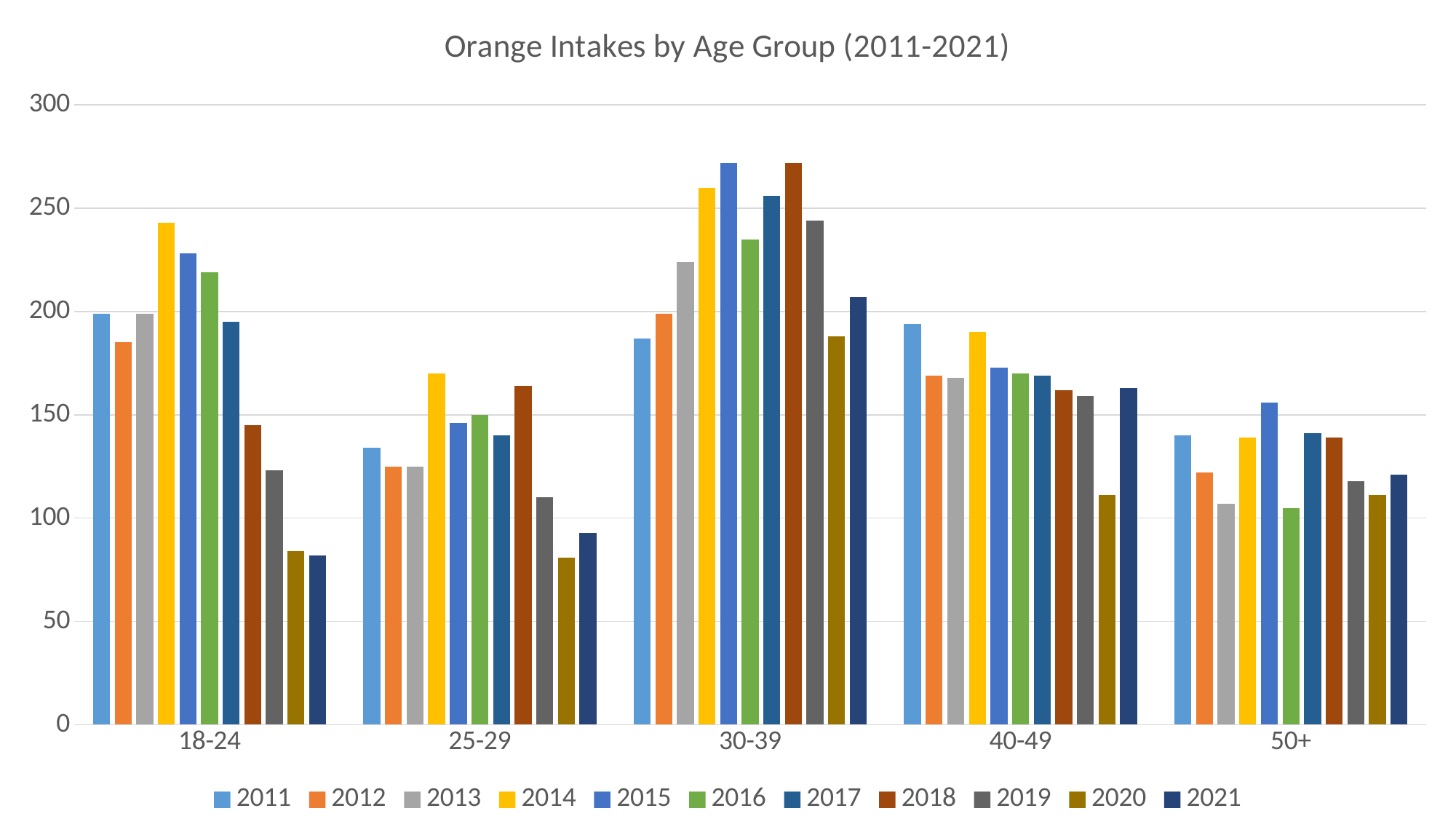
Is the 2015 value for the 30-39 age group greater or less than 250? greater In the 18-24 age group, which year has the highest bar? 2014 What kind of chart is shown on the slide? Bar chart What is the title of the chart? Orange Intakes by Age Group (2011-2021) Which age group has the highest 2014 bar? 30-39 How many series (years) does the legend list? 11 In the 40-49 age group, which year has the lowest bar? 2020 Is the 2020 value for the 18-24 age group greater or less than 100? less In the 50+ age group, which year has the highest bar? 2015 In the 25-29 age group, which year has the lowest bar? 2020 Which is larger: the 2011 value for 18-24 or the 2011 value for 25-29? 18-24 How many age groups are shown on the x axis? 5